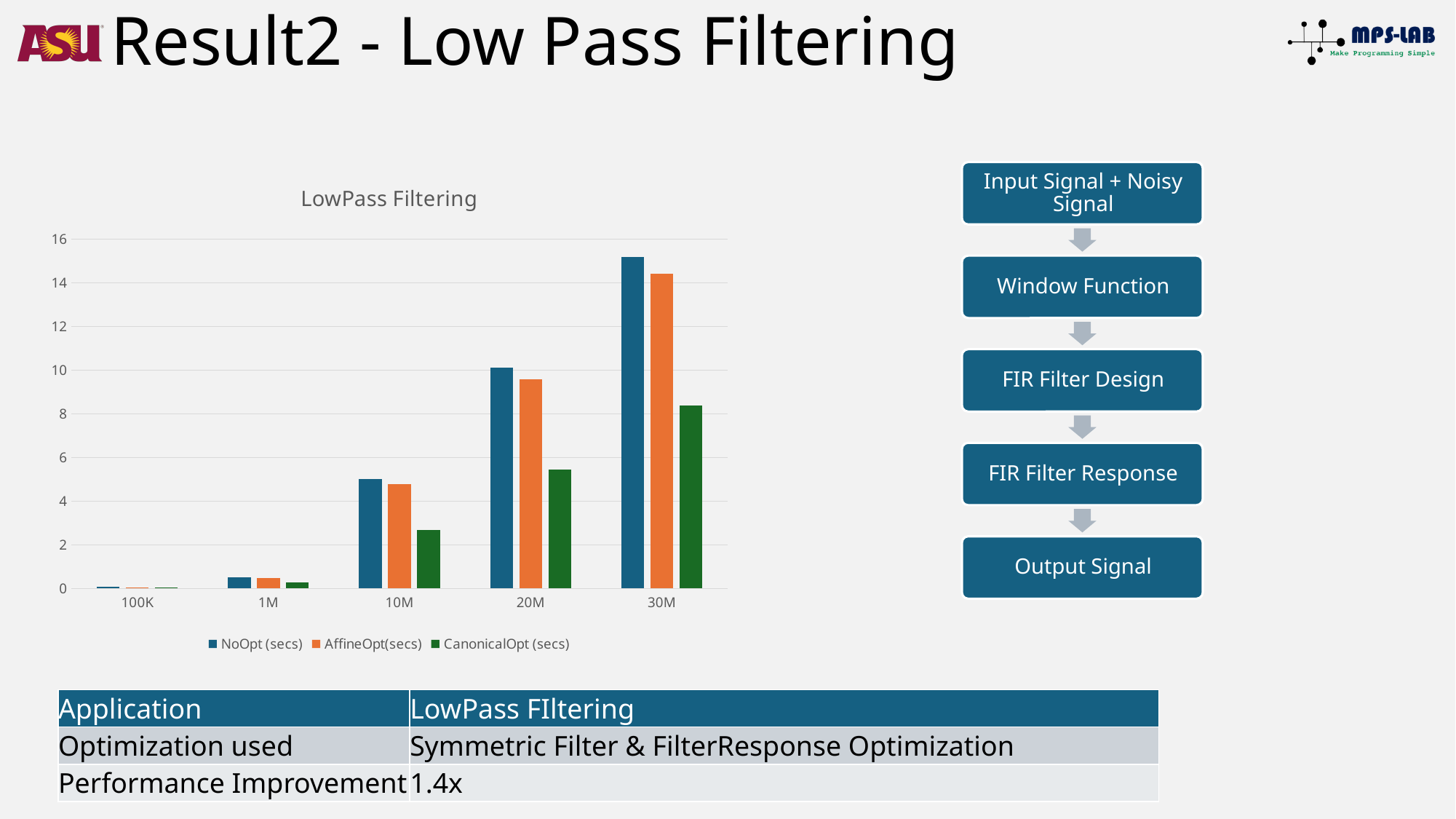
Do the NoOpt (secs) values rise or fall as you move from 100K to 30M along the x axis? rise Which category has the highest NoOpt (secs) value? 30M How many series does the chart's legend list? 3 How many categories are shown on the x axis of the chart? 5 What is the title of the chart? LowPass Filtering Which category has the lowest CanonicalOpt (secs) value? 100K At 20M, which is larger: AffineOpt(secs) or CanonicalOpt (secs)? AffineOpt(secs) Is the NoOpt (secs) value for 30M greater or less than 14? greater At 30M, which is larger: NoOpt (secs) or CanonicalOpt (secs)? NoOpt (secs) Is the CanonicalOpt (secs) value for 20M greater or less than 6? less Is the AffineOpt(secs) value for 10M greater or less than 4? greater What kind of chart is shown on the slide? bar chart